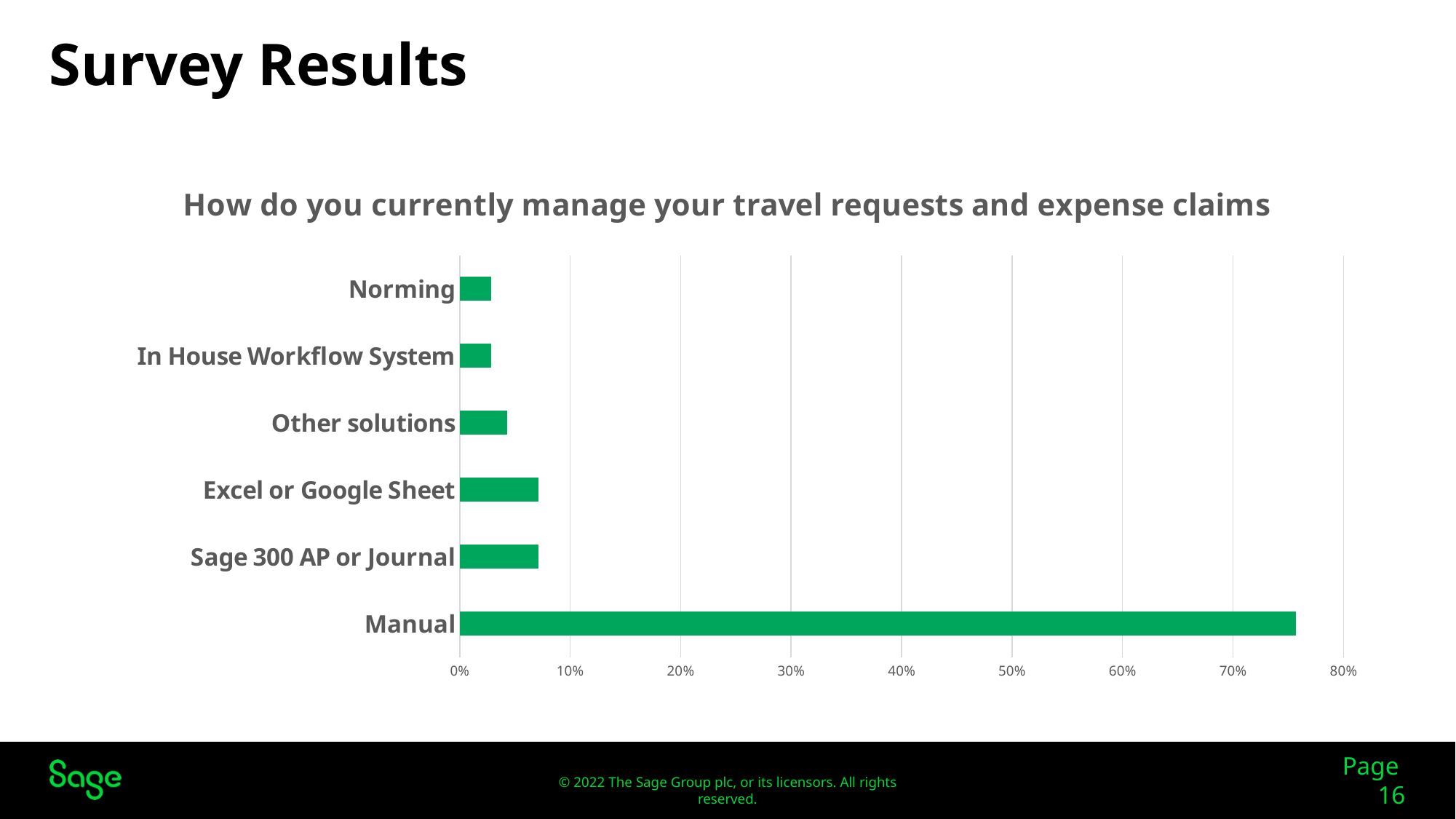
Which is larger, the value for Manual or the value for Excel or Google Sheet? Manual What kind of chart is shown on the slide? bar chart Is the value for Sage 300 AP or Journal greater or less than 20%? less What colour are the bars in the chart? green Is the value for Excel or Google Sheet greater or less than 10%? less Is the value for Norming greater or less than 10%? less Which is larger, the value for Excel or Google Sheet or the value for Other solutions? Excel or Google Sheet How many categories are shown in the chart? 6 Which category has the highest value? Manual What is the title of the chart? How do you currently manage your travel requests and expense claims